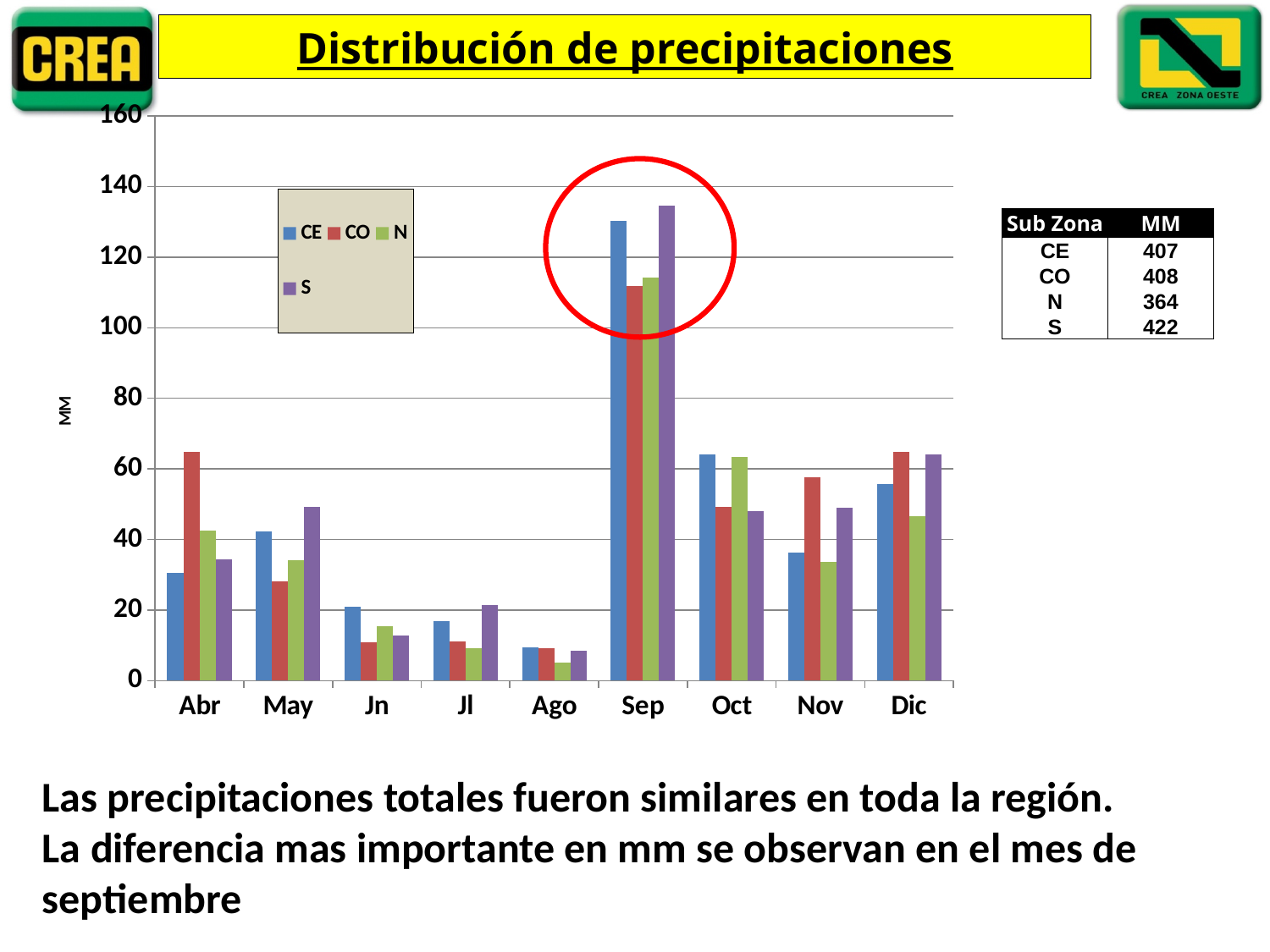
What kind of chart is shown on the slide? bar chart Is the value for N in Ago greater or less than 20? less In which month are the bars highest for all sub zones? Sep Which sub zone has the highest bar in Sep? S In which month are the bars lowest overall? Ago What is the label on the vertical axis of the chart? MM What is the title of the chart? Distribución de precipitaciones How many months are shown on the x axis of the chart? 9 In Abr, which is larger, the value for CO or the value for CE? CO How many series does the chart legend list? 4 In Nov, which is larger, the value for CO or the value for N? CO Is the value for CE in Sep greater or less than 120? greater